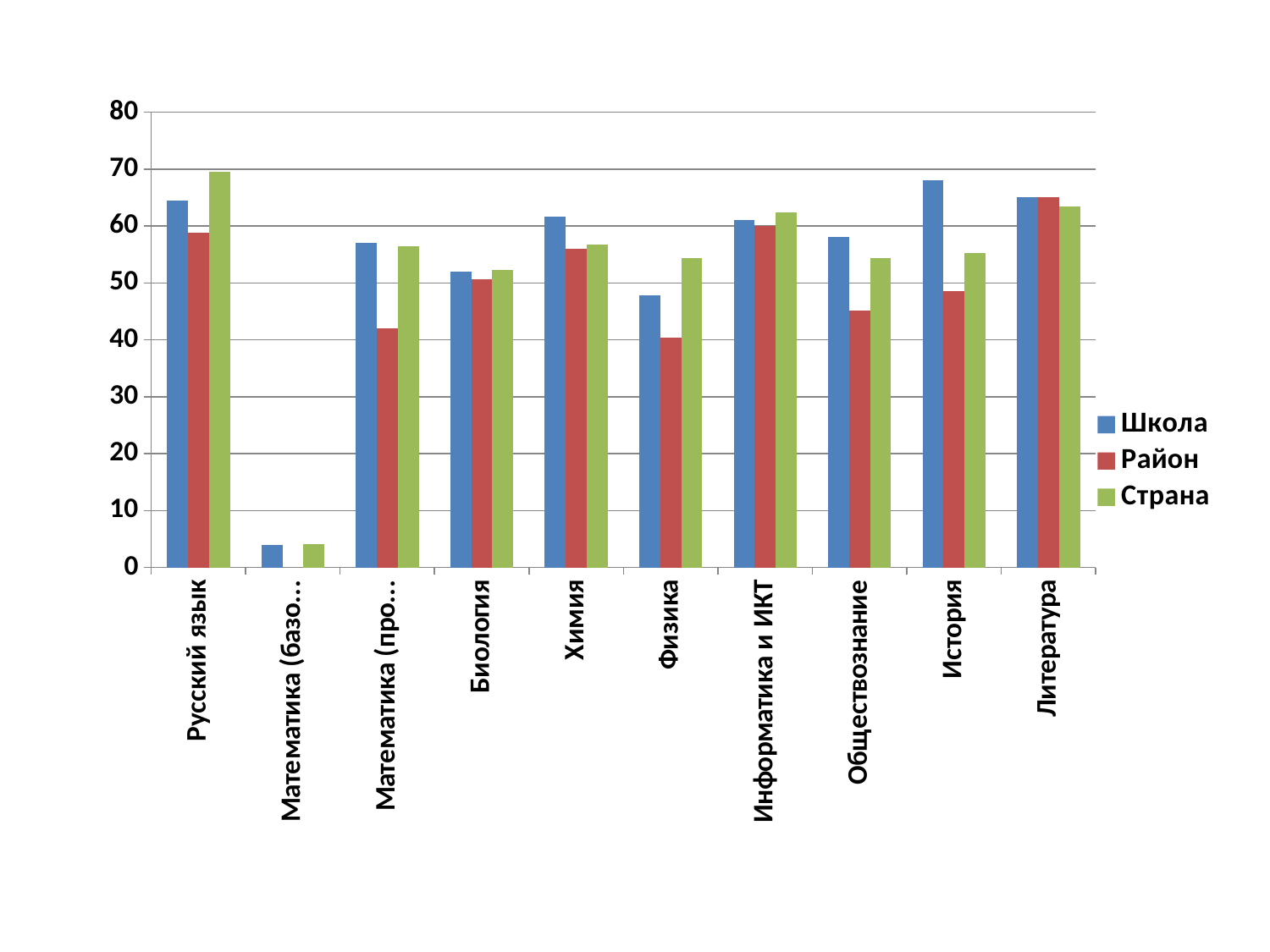
How many series does the legend list? 3 Which category has the highest Страна value? Русский язык For Физика, which is larger: the Школа value or the Страна value? Страна Which series is shown in blue? Школа Is the Район value for Обществознание greater or less than 50? less How many categories are shown along the x axis? 10 Is the Страна value for Русский язык greater or less than 60? greater What kind of chart is shown on the slide? bar chart For Русский язык, which is larger: the Школа value or the Страна value? Страна Is the Школа value for История greater or less than 60? greater For История, which is larger: the Школа value or the Район value? Школа